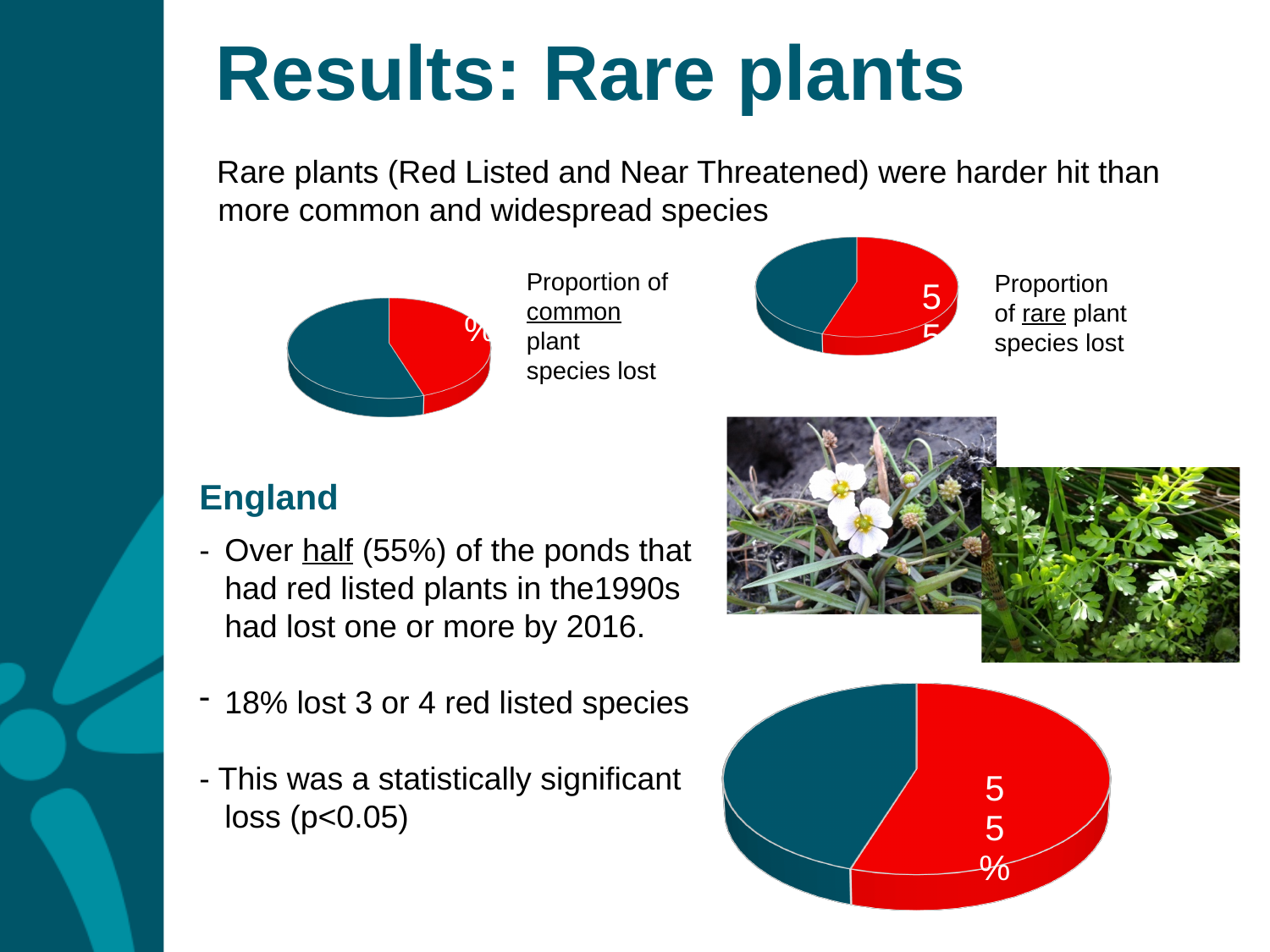
In the large pie chart at the bottom right, what share of the pie does the dark teal slice represent, given the red slice is 55%? 45% In the pie chart labelled 'Proportion of common plant species lost', which slice is larger, the red one or the dark teal one? dark teal What two colours are used for the slices in the pie charts on the slide? red and dark teal In the large pie chart at the bottom right, what value is printed on the red slice? 55% What is the caption next to the top-left pie chart? Proportion of common plant species lost In the pie chart labelled 'Proportion of rare plant species lost', which slice is larger, the red one or the dark teal one? red What kind of chart is the large chart at the bottom right of the slide? pie chart In the large pie chart at the bottom right, which slice is larger, the red one or the dark teal one? red How many slices does the large pie chart at the bottom right have? 2 How many pie charts are shown on the slide? 3